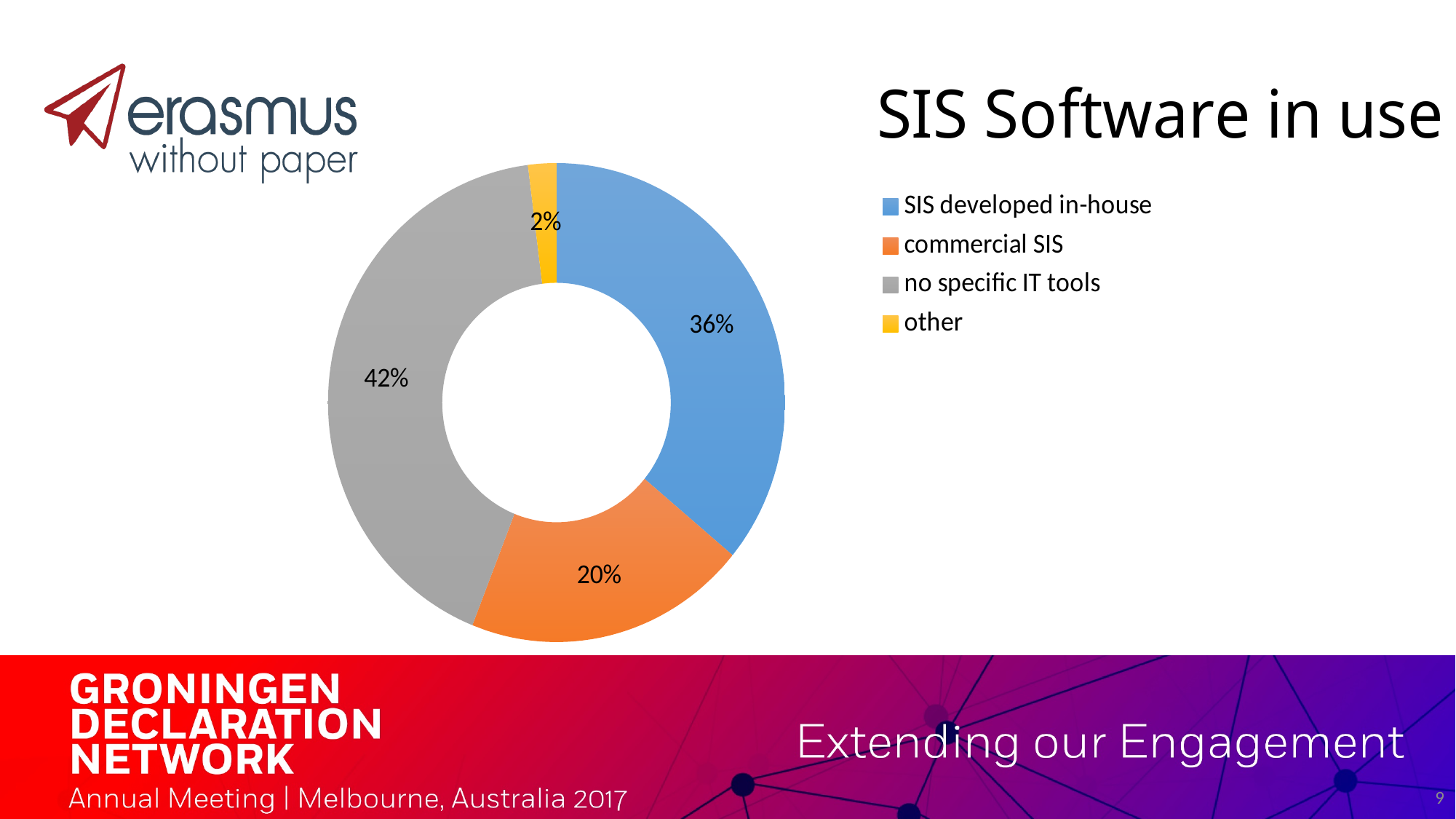
Which category has the smallest share of the chart? other What is the difference in percentage points between 'no specific IT tools' and 'SIS developed in-house'? 6 Which is larger, 'SIS developed in-house' or 'commercial SIS'? SIS developed in-house Which category has the largest share of the chart? no specific IT tools What percentage of the chart is 'commercial SIS'? 20% What kind of chart is shown on the slide? doughnut chart What percentage of the chart is 'other'? 2% What percentage of the chart is 'no specific IT tools'? 42% What percentage of the chart is 'SIS developed in-house'? 36% Which colour represents 'commercial SIS' in the chart? orange What is the title of the chart? SIS Software in use How many categories does the chart show? 4